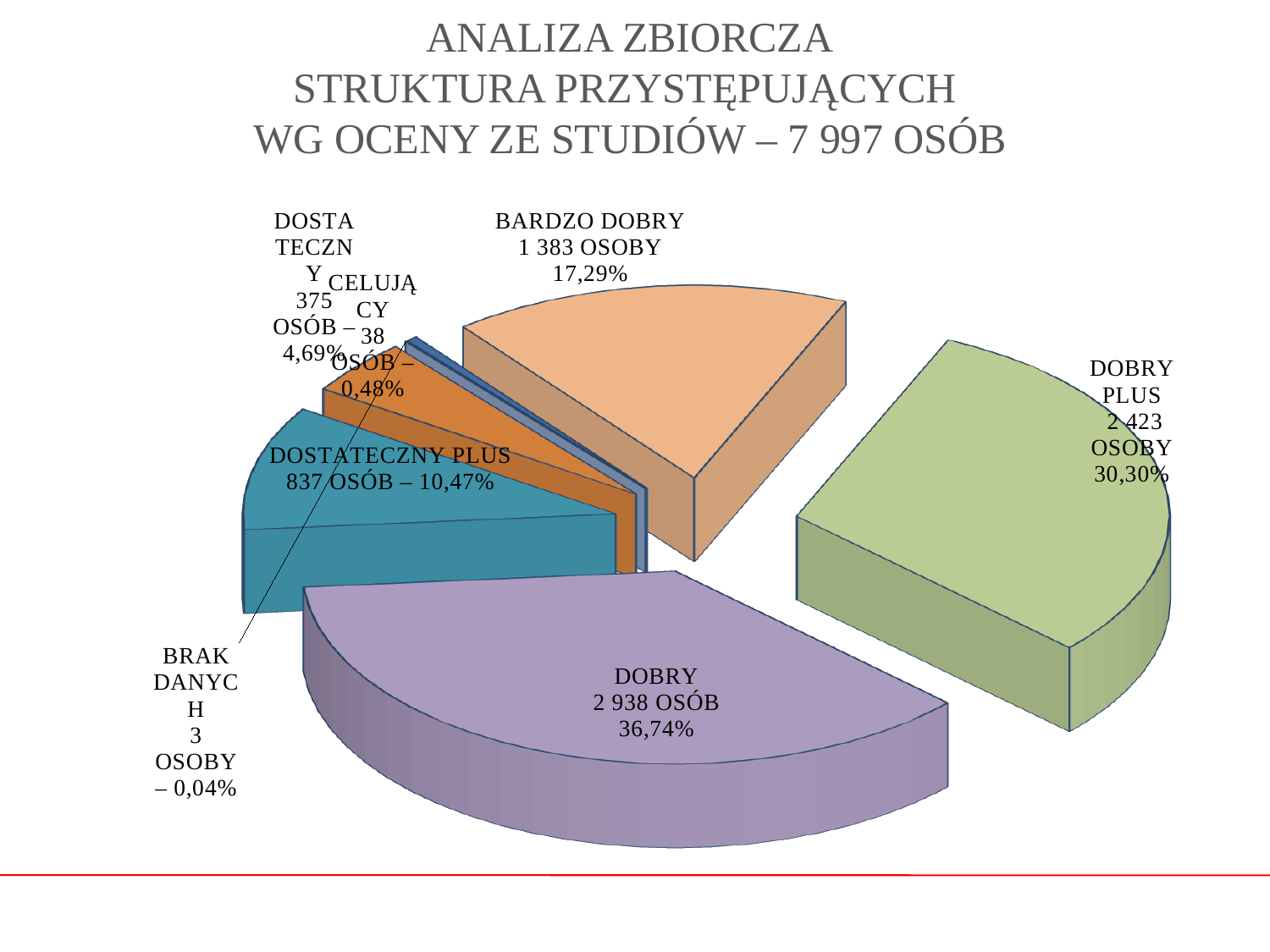
How many people are in the BARDZO DOBRY category? 1 383 What percentage share does the DOSTATECZNY slice have? 4,69% What percentage share does the DOSTATECZNY PLUS slice have? 10,47% What is the difference in number of people between DOBRY and DOBRY PLUS? 515 How many people are in the CELUJĄCY category? 38 How many categories (slices) does the pie chart have? 7 What percentage share does the DOBRY PLUS slice have? 30,30% Which category has the largest slice of the pie? DOBRY Which category has the smallest slice of the pie? BRAK DANYCH How many people are in the DOBRY category? 2 938 What kind of chart is shown on the slide? pie chart Which category has more people, BARDZO DOBRY or DOSTATECZNY PLUS? BARDZO DOBRY